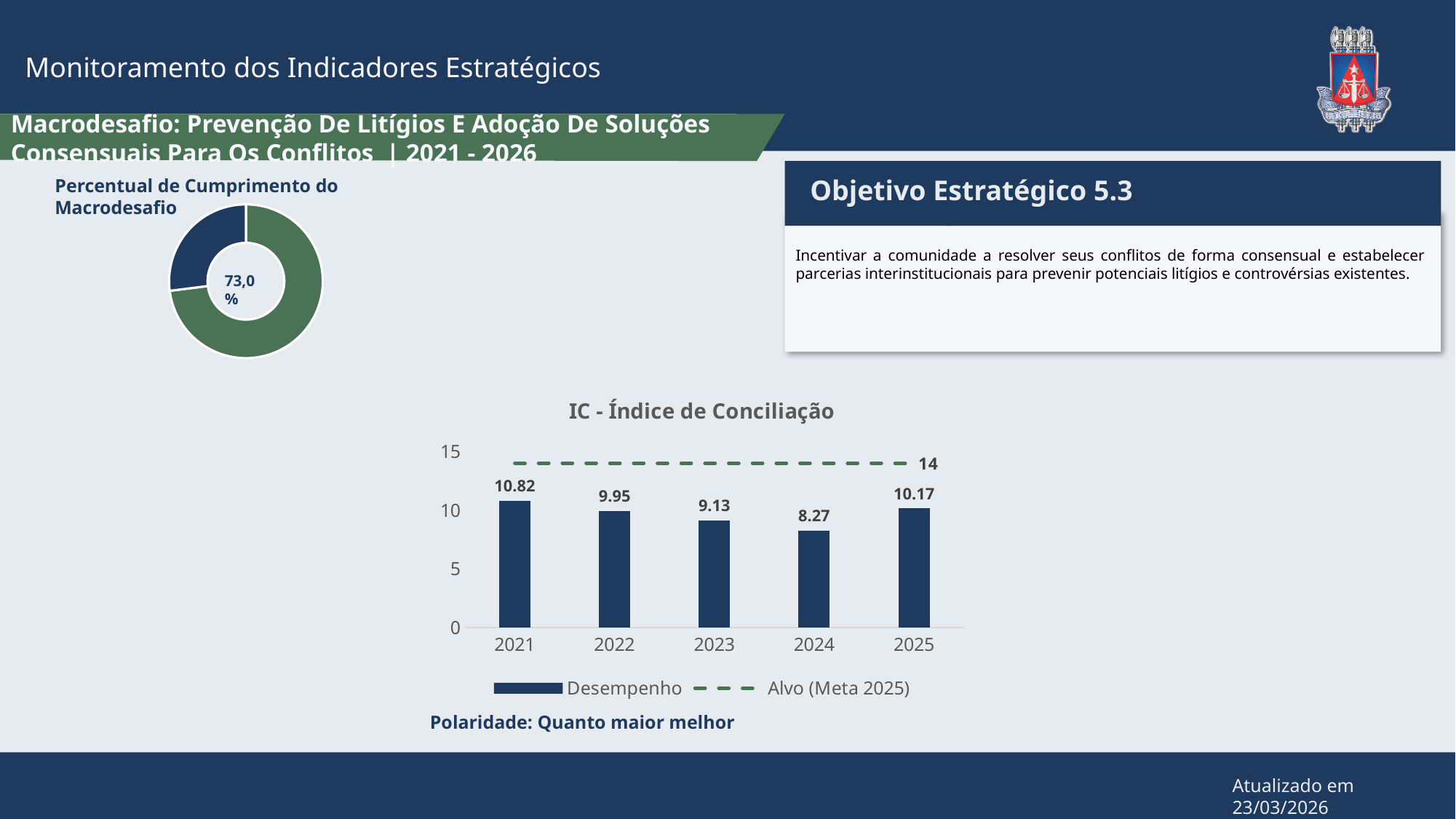
In the 'IC - Índice de Conciliação' chart, which year has the highest Desempenho value? 2021 In the 'IC - Índice de Conciliação' chart, which year has the lowest Desempenho value? 2024 In the 'IC - Índice de Conciliação' chart, what is the difference between the Desempenho values for 2025 and 2024? 1.90 In the 'Percentual de Cumprimento do Macrodesafio' donut chart, what percentage is shown in the centre? 73,0% In the 'IC - Índice de Conciliação' chart, do the Desempenho values rise or fall from 2021 to 2024? Fall In the 'IC - Índice de Conciliação' chart, which is larger, the Desempenho value for 2022 or for 2023? 2022 In the 'IC - Índice de Conciliação' chart, what is the Desempenho value for 2021? 10.82 In the 'IC - Índice de Conciliação' chart, how many years are shown on the x axis? 5 In the 'IC - Índice de Conciliação' chart, what is the value of the Alvo (Meta 2025) line? 14 In the 'IC - Índice de Conciliação' chart, how many series does the legend list? 2 In the 'IC - Índice de Conciliação' chart, what is the Desempenho value for 2024? 8.27 What kind of chart is 'IC - Índice de Conciliação'? Bar chart